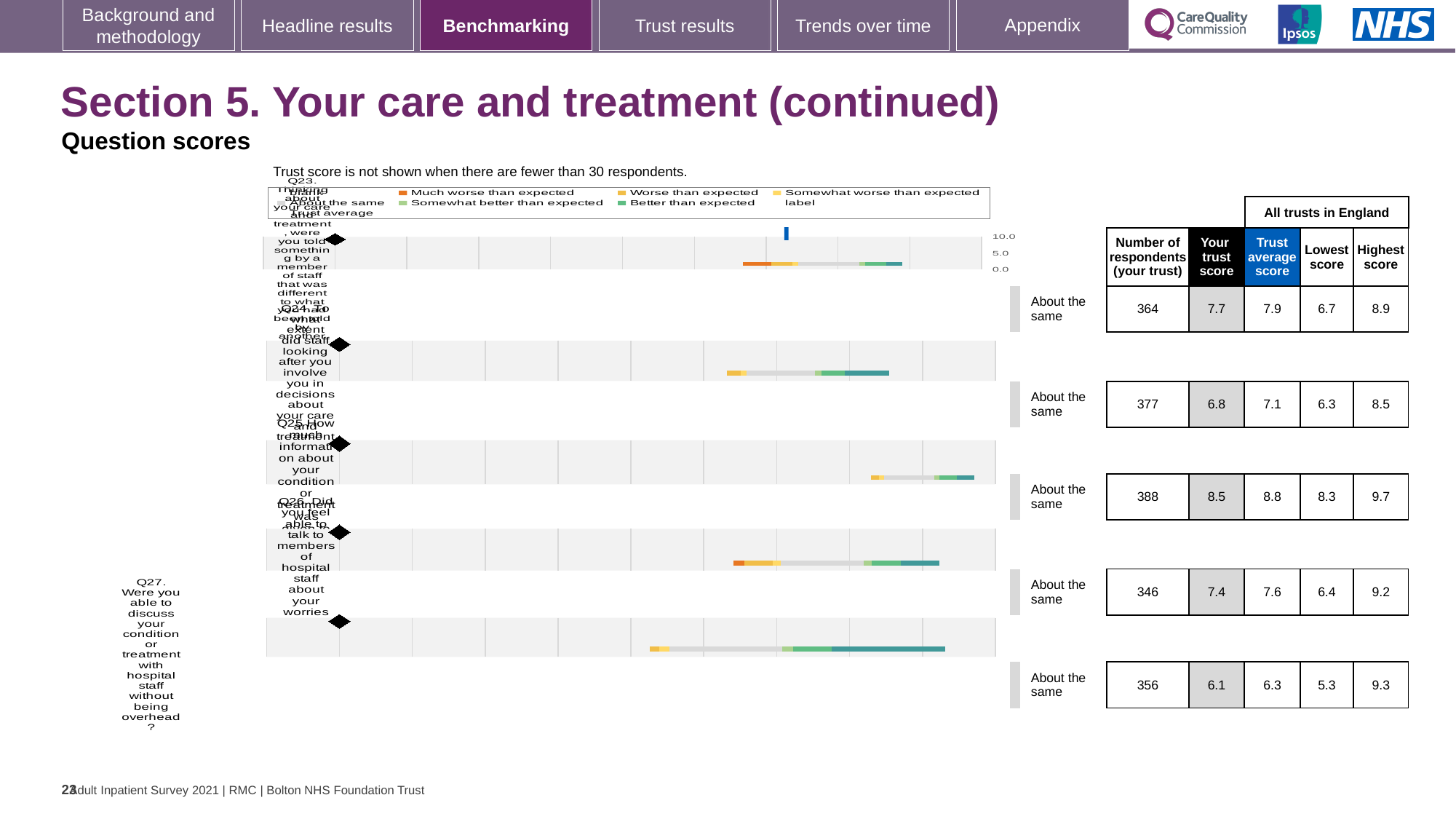
Which question has the lowest trust score for this trust? Q27 What is the difference between the trust average score and the trust score for Q23? 0.2 What is the highest score across all trusts in England for Q27 (discussing your condition without being overheard)? 9.3 What is the trust average score for Q24 (staff involving you in decisions about your care and treatment)? 7.1 Which question has the highest trust score for this trust? Q25 How many respondents answered Q25 (how much information about your condition or treatment)? 388 What benchmark category is shown for every question on this slide? About the same For Q26, which is larger: the trust score or the trust average score? Trust average score What is the trust score for Q23 (told something different by a member of staff)? 7.7 What kind of chart is used to show the question scores on this slide? bar chart How many questions (Q23 to Q27) are plotted in the chart? 5 What is the difference between the highest score (9.7) and the lowest score (8.3) for Q25? 1.4